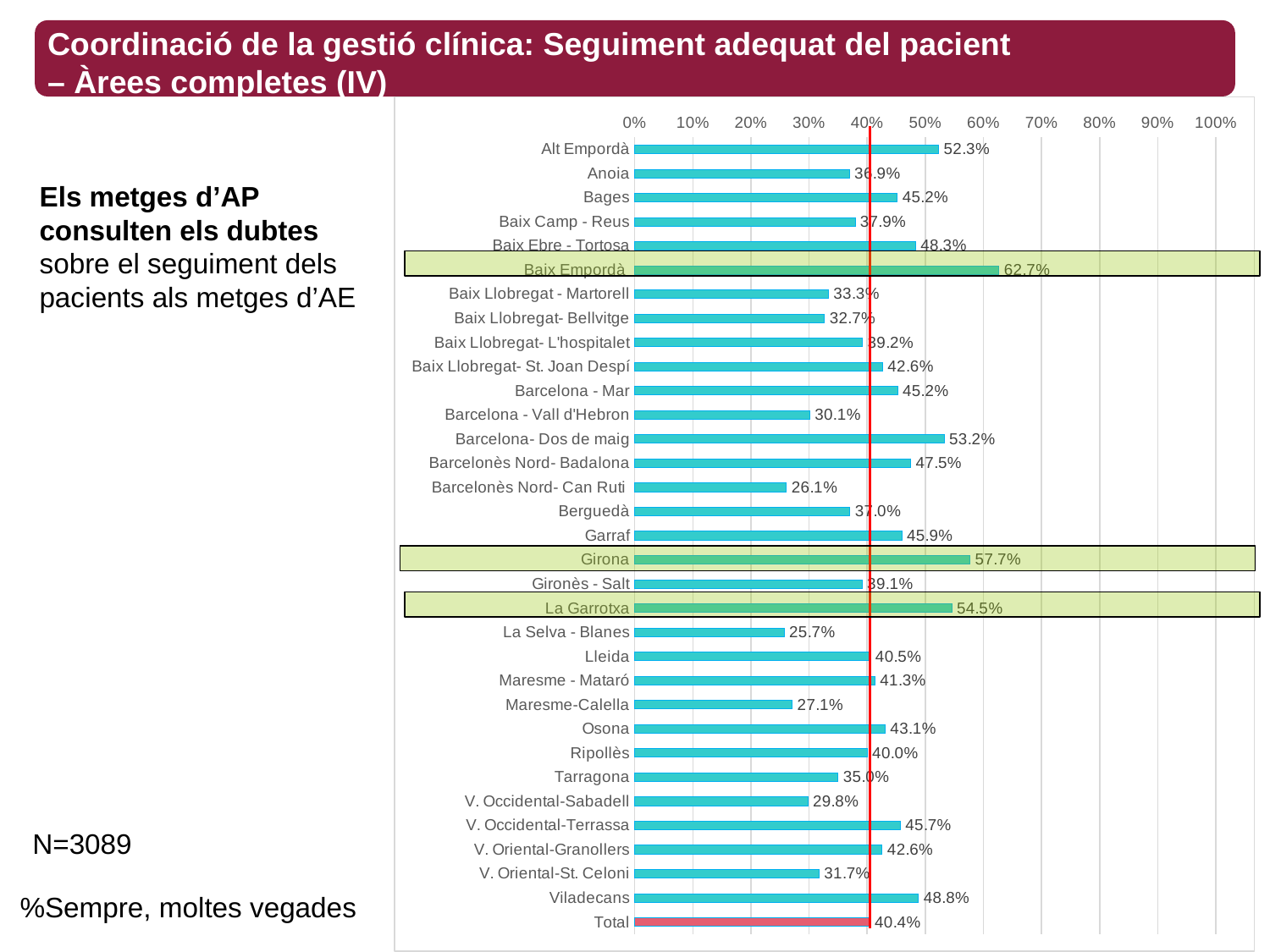
What is the value for Viladecans? 48.8% Is the value for Barcelonès Nord- Can Ruti greater or less than 30%? less Which is larger, the value for Lleida or the value for Osona? Osona What is the value for Total? 40.4% What is the value for Barcelona- Dos de maig? 53.2% Which area has the highest value? Baix Empordà What is the value for Baix Empordà? 62.7% What is the sample size (N) stated on the slide? N=3089 Which area has the lowest value? La Selva - Blanes What is the difference between the values for Baix Empordà and Girona? 5.0 percentage points What kind of chart is shown on the slide? Bar chart What is the difference between the values for Girona and La Garrotxa? 3.2 percentage points